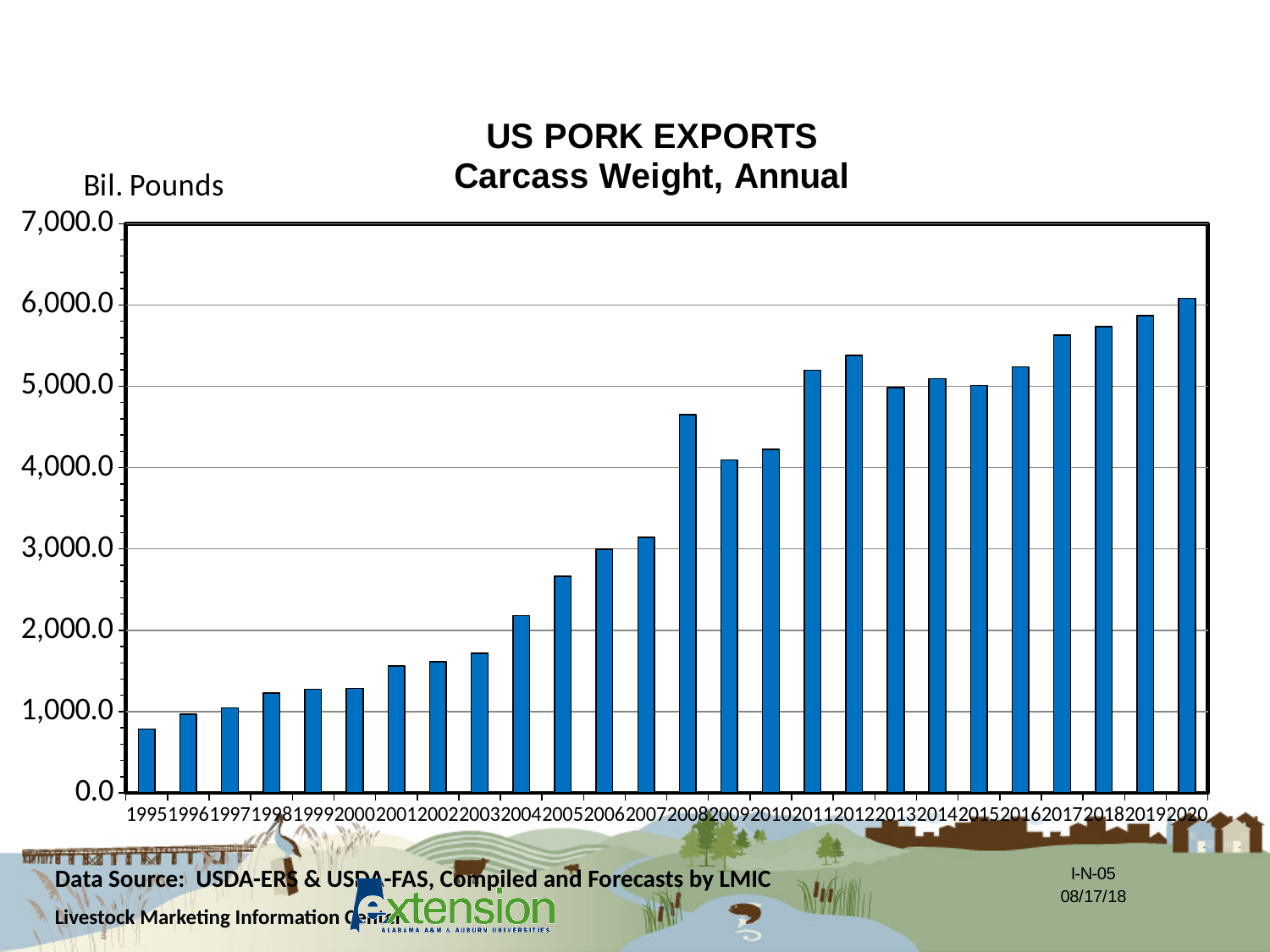
How many years (bars) are plotted in the chart? 26 Which year has the highest US pork exports in the chart? 2020 What kind of chart is shown on the slide? bar chart Do US pork exports generally rise or fall from 1995 to 2020? rise Which year has the larger value, 2012 or 2013? 2012 Is the value for 2008 greater or less than 4,000.0? greater Is the value for 2020 greater or less than 6,000.0? greater What unit is shown on the vertical axis label of the chart? Bil. Pounds Is the value for 2001 greater or less than 2,000.0? less Which year has the lowest US pork exports in the chart? 1995